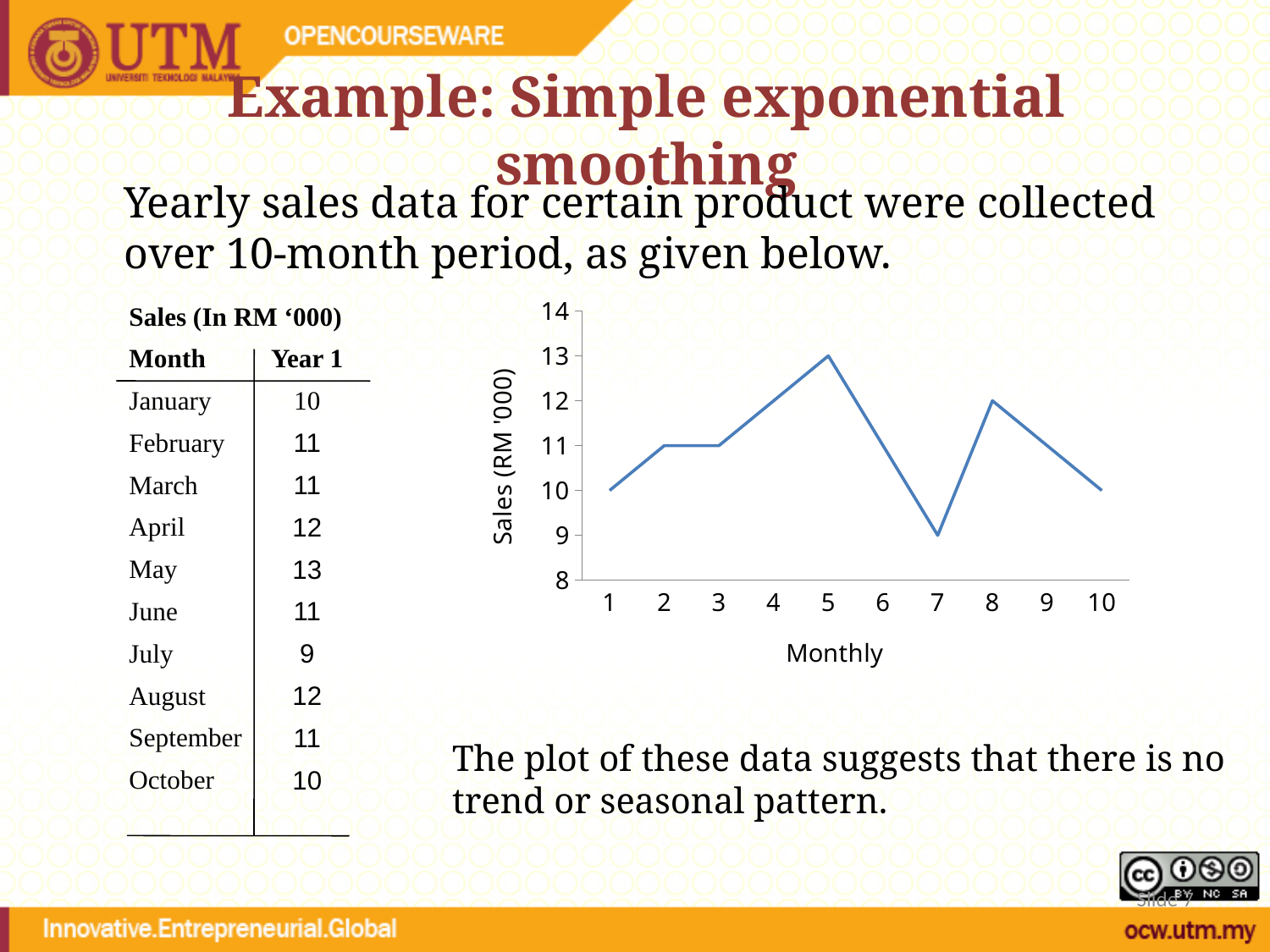
What is the difference between the sales value at month 5 and at month 7? 4 What kind of chart is shown on the slide? line chart What is the sales value at month 7 on the line chart? 9 What is the sales value at month 1 on the line chart? 10 How many data points are plotted on the line chart? 10 Which is larger on the line chart, the sales value at month 8 or at month 9? month 8 What is the label of the vertical axis on the line chart? Sales (RM '000) What is the sales value at month 5 on the line chart? 13 What is the label of the horizontal axis on the line chart? Monthly Which month has the highest sales value on the line chart? 5 Which month has the lowest sales value on the line chart? 7 Is the sales value at month 4 greater or less than 11? greater